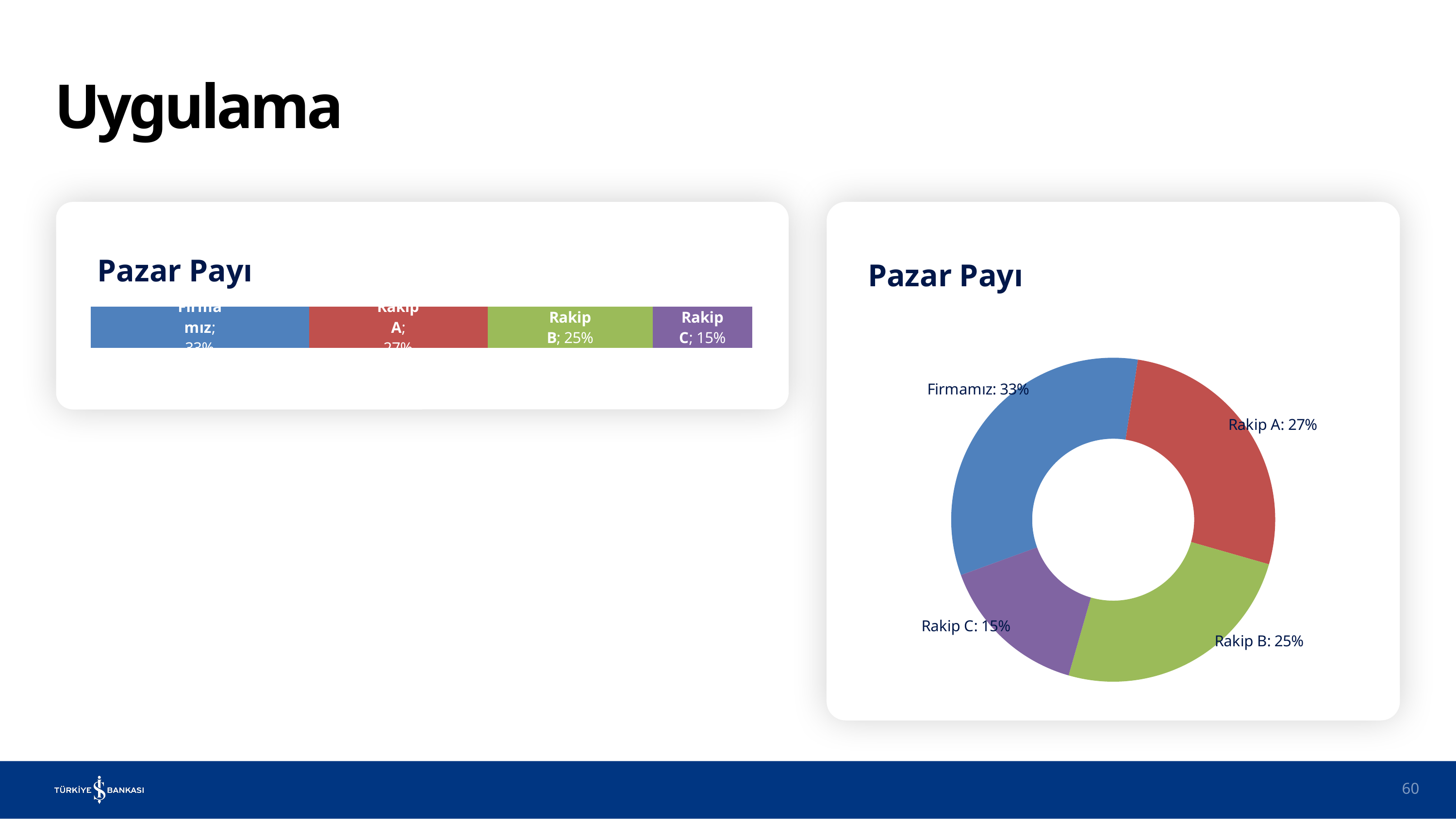
In the bar chart on the left, what is the value shown for Rakip C? 15% In the doughnut chart on the right, which category has the smallest share? Rakip C What kind of chart is the chart on the right side of the slide? Doughnut chart In the doughnut chart on the right, how much larger is the share of Firmamız than that of Rakip C? 18% In the bar chart on the left, what is the difference between the values for Rakip B and Rakip C? 10% What kind of chart is the chart on the left side of the slide? Bar chart In the doughnut chart on the right, which is larger: Rakip A or Rakip B? Rakip A In the doughnut chart on the right, which category has the largest share? Firmamız In the doughnut chart on the right, what is the share for Rakip A? 27% In the bar chart on the left, what is the value shown for Rakip B? 25% In the doughnut chart on the right, what is the share for Firmamız? 33% How many slices does the doughnut chart on the right have? 4